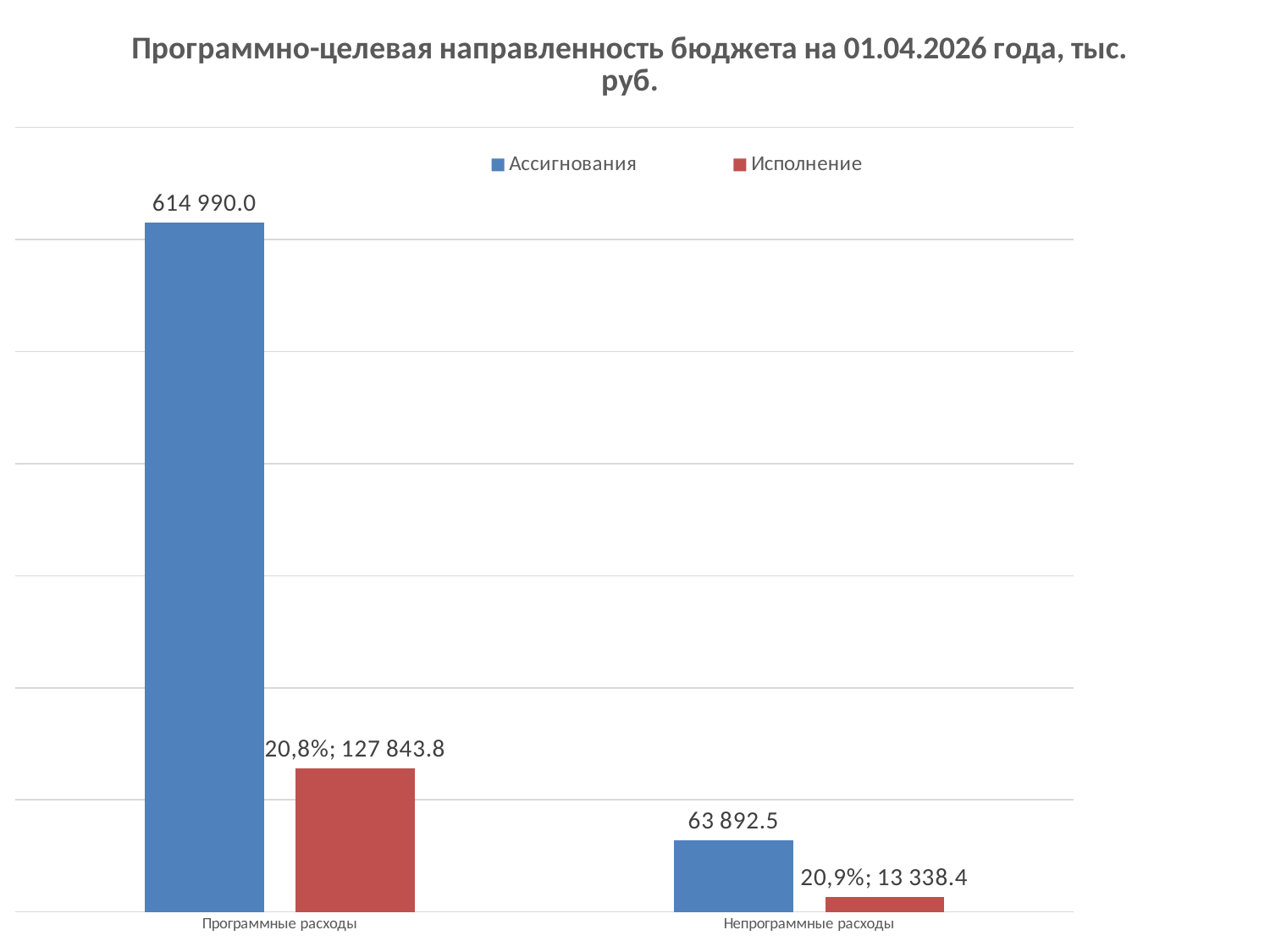
Which is larger: Исполнение for Программные расходы or Ассигнования for Непрограммные расходы? Исполнение for Программные расходы How many series does the legend list? 2 Which category has the lowest Исполнение value? Непрограммные расходы What is the value of Ассигнования for Непрограммные расходы? 63 892.5 What is the difference between Ассигнования for Программные расходы and Ассигнования for Непрограммные расходы? 551 097.5 Which category has the highest Ассигнования value? Программные расходы How many categories are shown on the x axis? 2 What type of chart is shown on the slide? Bar chart What is the value of Ассигнования for Программные расходы? 614 990.0 What percentage is shown next to the Исполнение bar for Непрограммные расходы? 20,9% What is the value of Исполнение for Программные расходы? 127 843.8 What is the value of Исполнение for Непрограммные расходы? 13 338.4